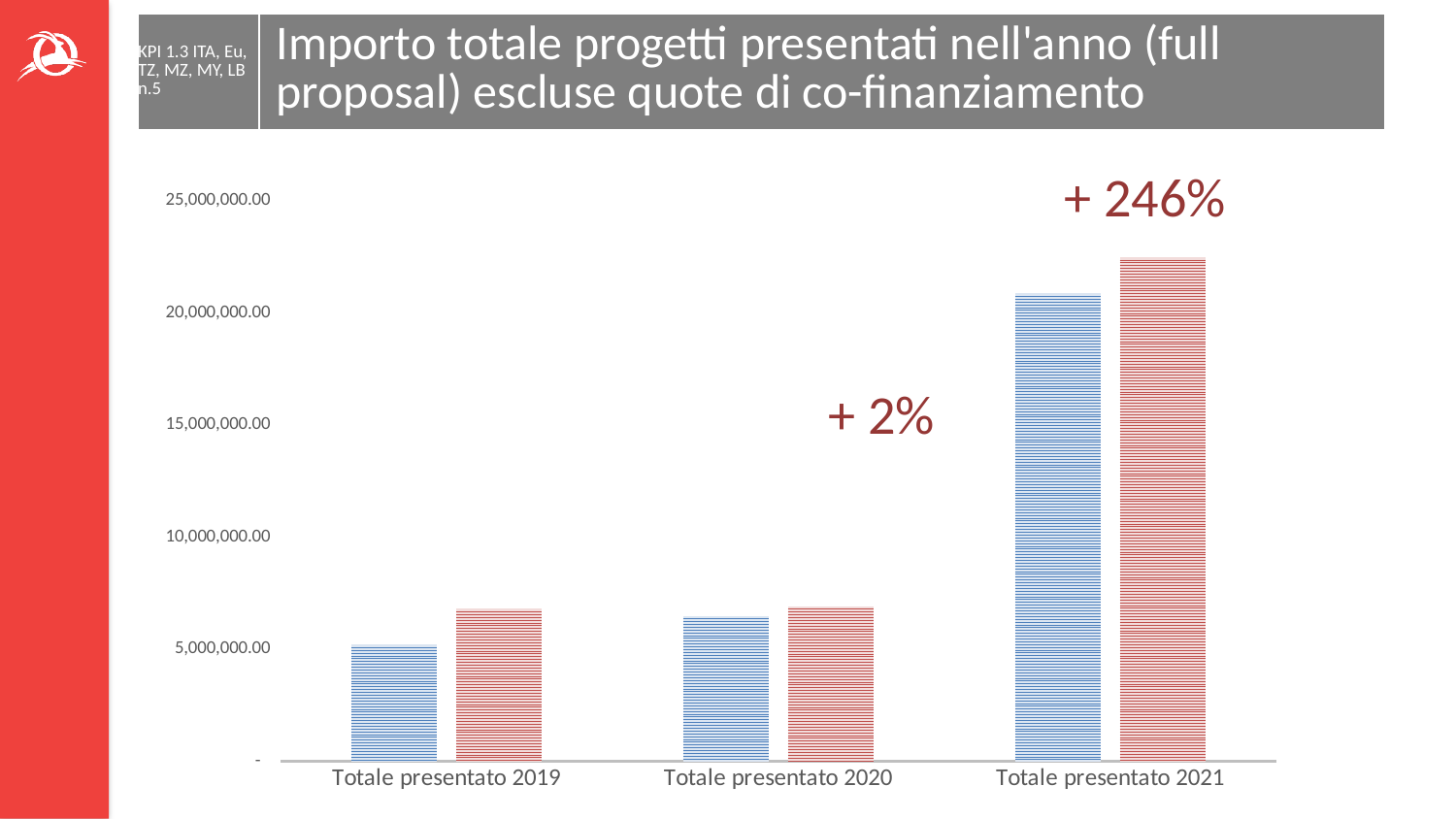
Do the blue bars rise or fall from Totale presentato 2019 to Totale presentato 2021? rise Which is larger, the blue bar for Totale presentato 2021 or the blue bar for Totale presentato 2020? Totale presentato 2021 What kind of chart is shown on the slide? bar chart Is the value of the red bar for Totale presentato 2019 greater or less than 5,000,000.00? greater How many bars are plotted for each category? 2 Which category has the shortest blue bar? Totale presentato 2019 What percentage annotation is shown above the bars for Totale presentato 2021? + 246% For Totale presentato 2019, which bar is larger, the blue one or the red one? the red one Is the value of the red bar for Totale presentato 2021 greater or less than 20,000,000.00? greater Which category has the tallest bars? Totale presentato 2021 How many categories are shown on the x axis? 3 Is the value of the blue bar for Totale presentato 2019 greater or less than 10,000,000.00? less